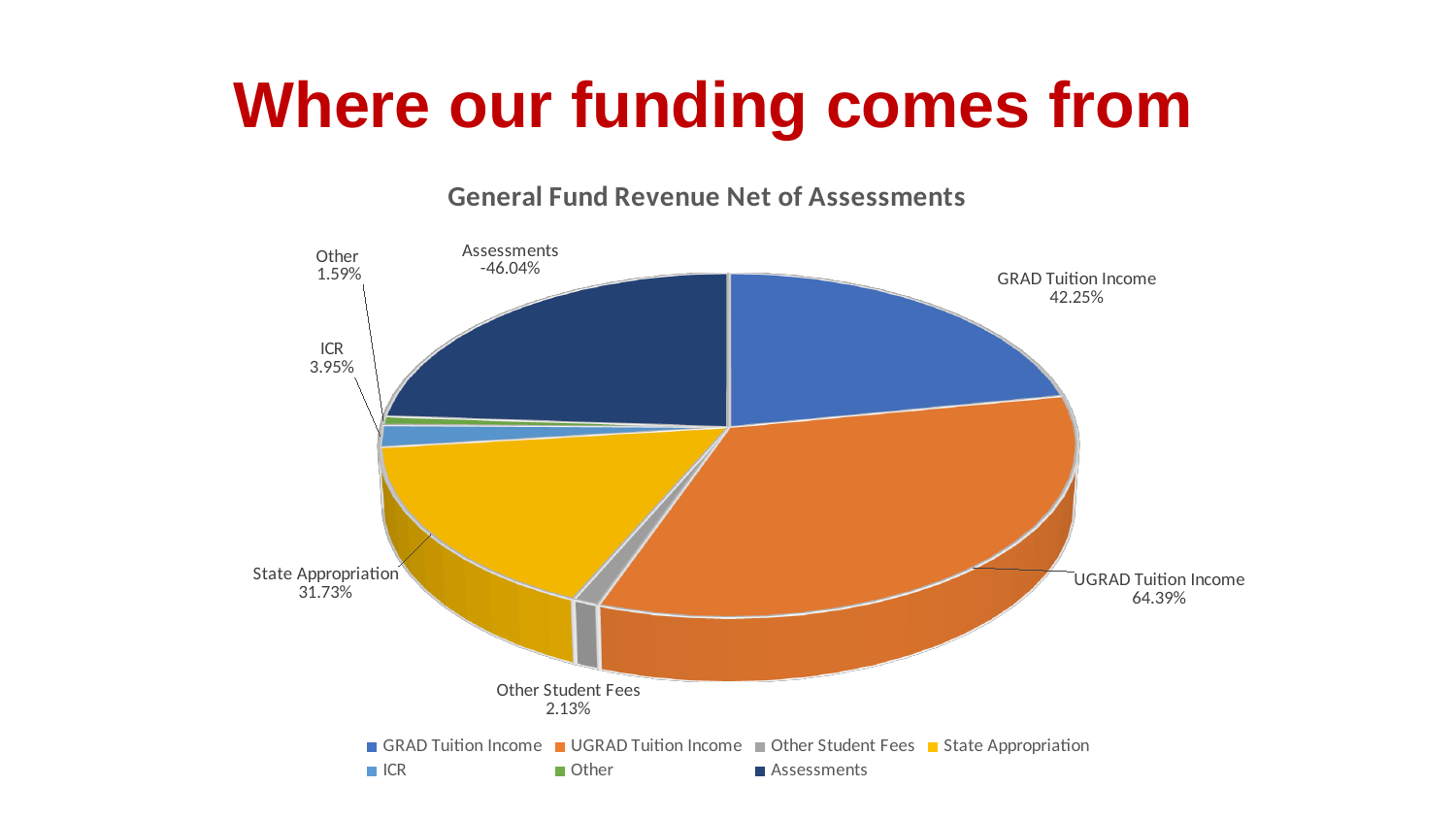
Which category has the smallest positive percentage in the chart? Other What percentage is shown for GRAD Tuition Income? 42.25% What percentage is shown for Other Student Fees? 2.13% Which category has the highest percentage in the chart? UGRAD Tuition Income What type of chart is shown on the slide? Pie chart What percentage is shown for Assessments? -46.04% How many categories does the legend list? 7 What percentage is shown for State Appropriation? 31.73% What is the title of the chart? General Fund Revenue Net of Assessments Which is larger, GRAD Tuition Income or State Appropriation? GRAD Tuition Income How many percentage points higher is UGRAD Tuition Income than GRAD Tuition Income? 22.14 What percentage is shown for UGRAD Tuition Income? 64.39%